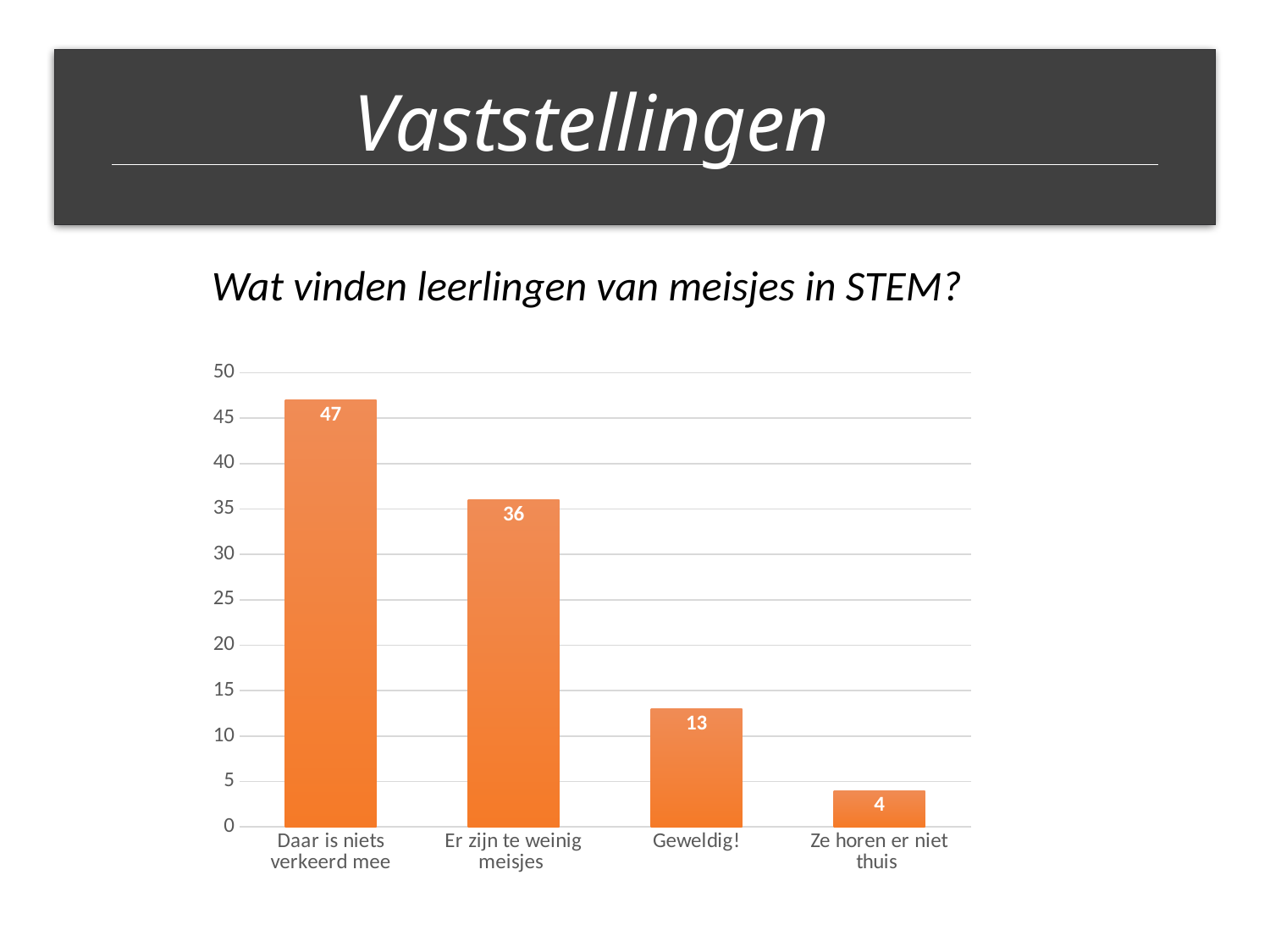
What is the value for "Er zijn te weinig meisjes"? 36 Which category has the highest value? Daar is niets verkeerd mee What is the value for "Ze horen er niet thuis"? 4 What is the value for "Geweldig!"? 13 Which is larger, the value for "Er zijn te weinig meisjes" or the value for "Geweldig!"? Er zijn te weinig meisjes What is the difference between the values for "Daar is niets verkeerd mee" and "Er zijn te weinig meisjes"? 11 Which category has the lowest value? Ze horen er niet thuis Do the values rise or fall from left to right along the x axis? Fall How many categories are shown in the chart? 4 What kind of chart is shown on the slide? Bar chart What is the difference between the values for "Geweldig!" and "Ze horen er niet thuis"? 9 What is the value for "Daar is niets verkeerd mee"? 47